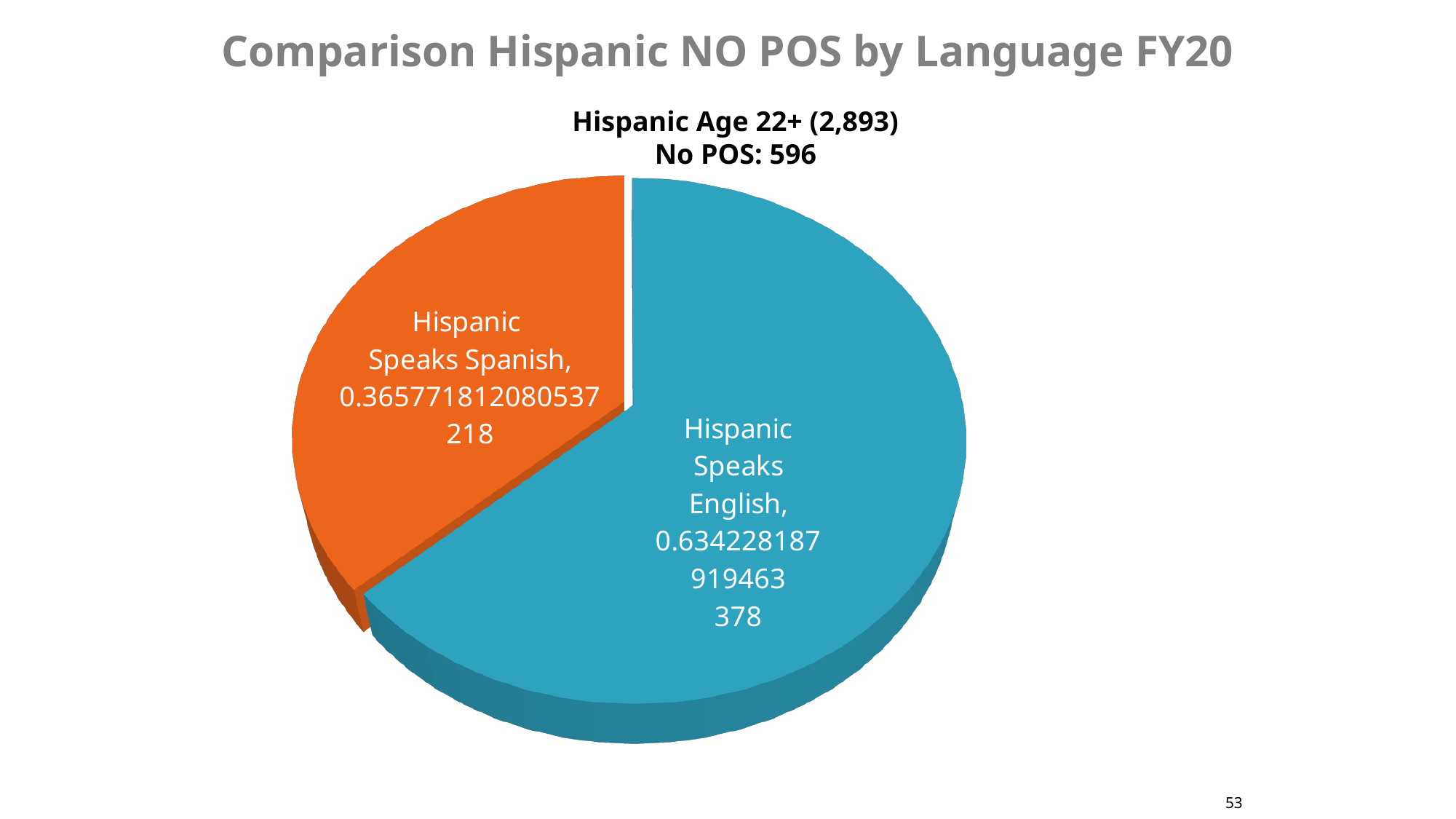
What kind of chart is shown on the slide? Pie chart What is the value shown for the Hispanic Speaks English slice? 0.634228187919463 What share of the pie does the Hispanic Speaks Spanish slice represent? 0.365771812080537 Which slice of the pie is the largest? Hispanic Speaks English What is the value shown for the Hispanic Speaks Spanish slice? 0.365771812080537 What is the difference between the Hispanic Speaks English value and the Hispanic Speaks Spanish value? 0.268456375838926 What is the title printed above the pie chart? Hispanic Age 22+ (2,893) No POS: 596 Which slice of the pie is the smallest? Hispanic Speaks Spanish What colour is the Hispanic Speaks Spanish slice? Orange How many slices does the pie chart have? 2 Which is larger, the Hispanic Speaks English slice or the Hispanic Speaks Spanish slice? Hispanic Speaks English